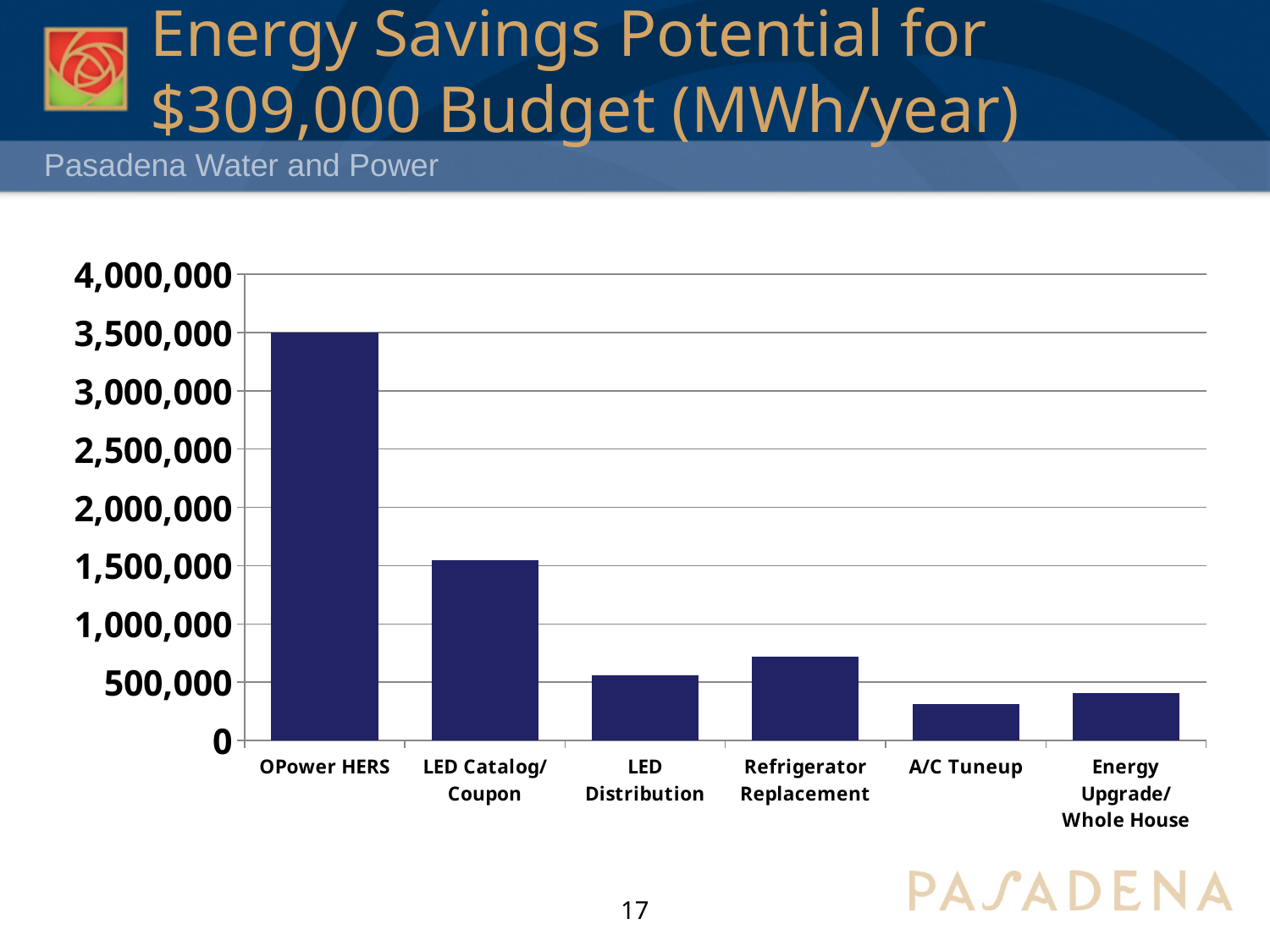
Is the value for LED Distribution greater or less than 1,000,000? less What type of chart is shown on the slide? bar chart Is the value for Refrigerator Replacement greater or less than 500,000? greater Which category has the lowest energy savings potential? A/C Tuneup Which is larger, the value for Refrigerator Replacement or the value for LED Distribution? Refrigerator Replacement Which is larger, the value for Energy Upgrade/Whole House or the value for A/C Tuneup? Energy Upgrade/Whole House How many categories are shown on the x axis of the chart? 6 Which category has the highest energy savings potential? OPower HERS Is the value for A/C Tuneup greater or less than 500,000? less What is the title of the chart on the slide? Energy Savings Potential for $309,000 Budget (MWh/year)